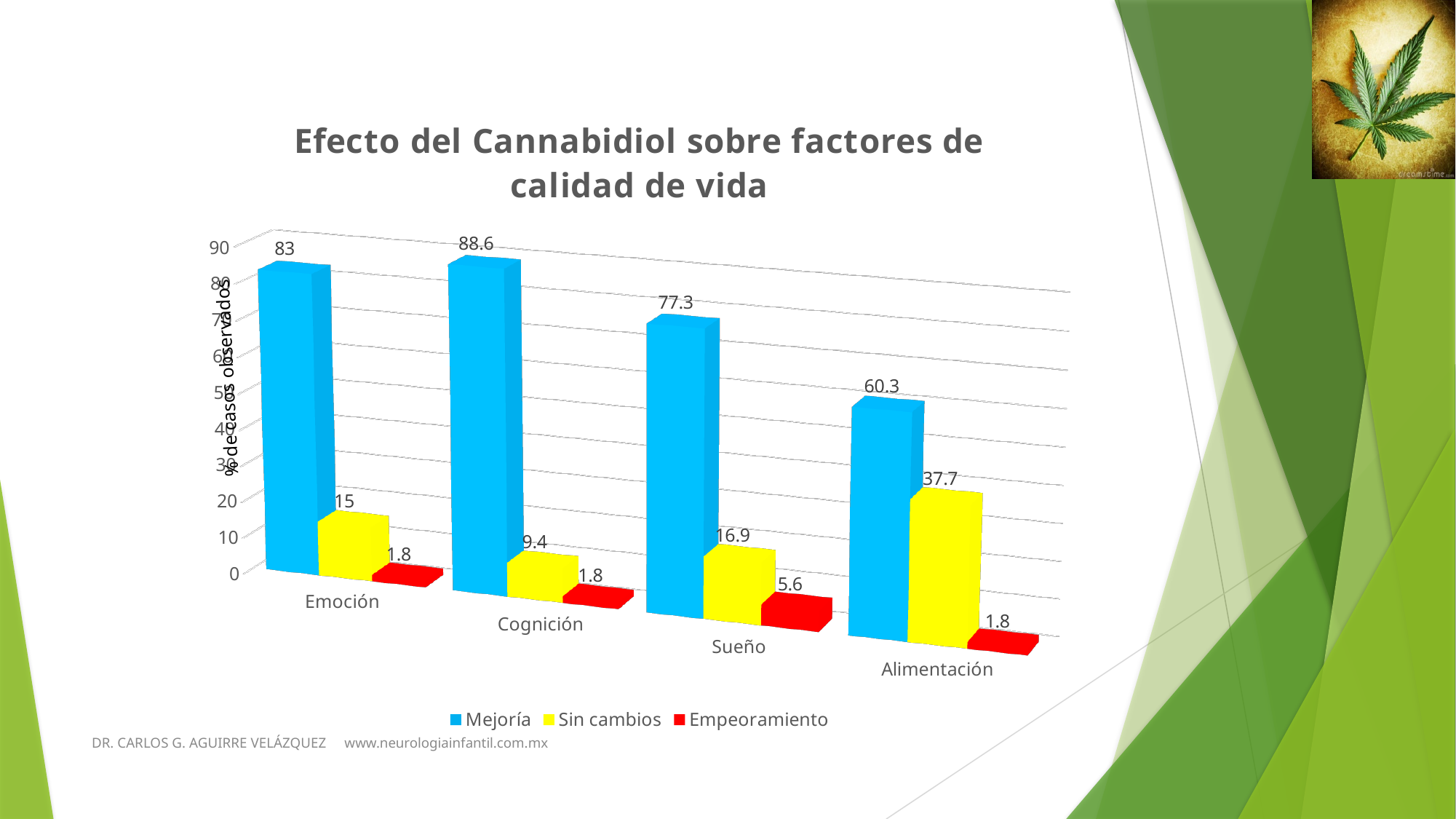
Do the Mejoría values rise or fall from Sueño to Alimentación? Fall How many categories are shown on the x axis? 4 What is the Mejoría value for Cognición? 88.6 What is the Empeoramiento value for Sueño? 5.6 What kind of chart is shown on the slide? Bar chart What colour represents the Empeoramiento series? Red How many series does the legend list? 3 Which category has the highest Mejoría value? Cognición Which category has the lowest Sin cambios value? Cognición What is the Sin cambios value for Alimentación? 37.7 Which is larger, the Sin cambios value for Emoción or for Sueño? Sueño What is the difference between the Mejoría values for Emoción and Alimentación? 22.7